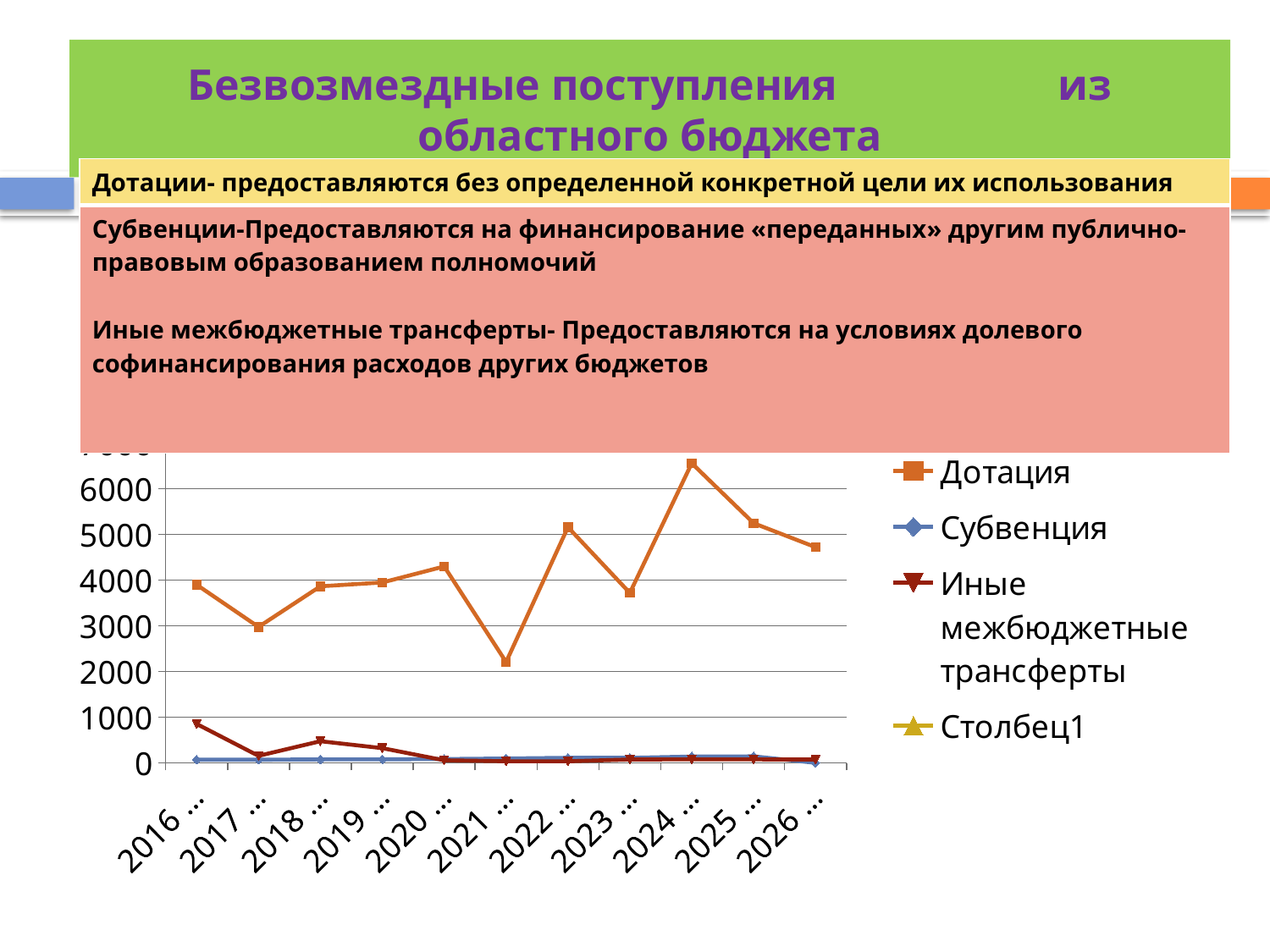
Is the value of Дотация in 2026 greater or less than 5000? less Is the value of Дотация in 2024 greater or less than 6000? greater Is the value of Иные межбюджетные трансферты in 2016 greater or less than 1000? less How many series does the chart legend list? 4 What kind of chart is shown on the slide? line chart In which year does the Дотация series reach its highest value? 2024 How many years are plotted along the x axis of the chart? 11 Which series has the larger value in 2016, Дотация or Иные межбюджетные трансферты? Дотация Does the Иные межбюджетные трансферты series generally rise or fall from 2016 to 2020? fall In which year does the Дотация series reach its lowest value? 2021